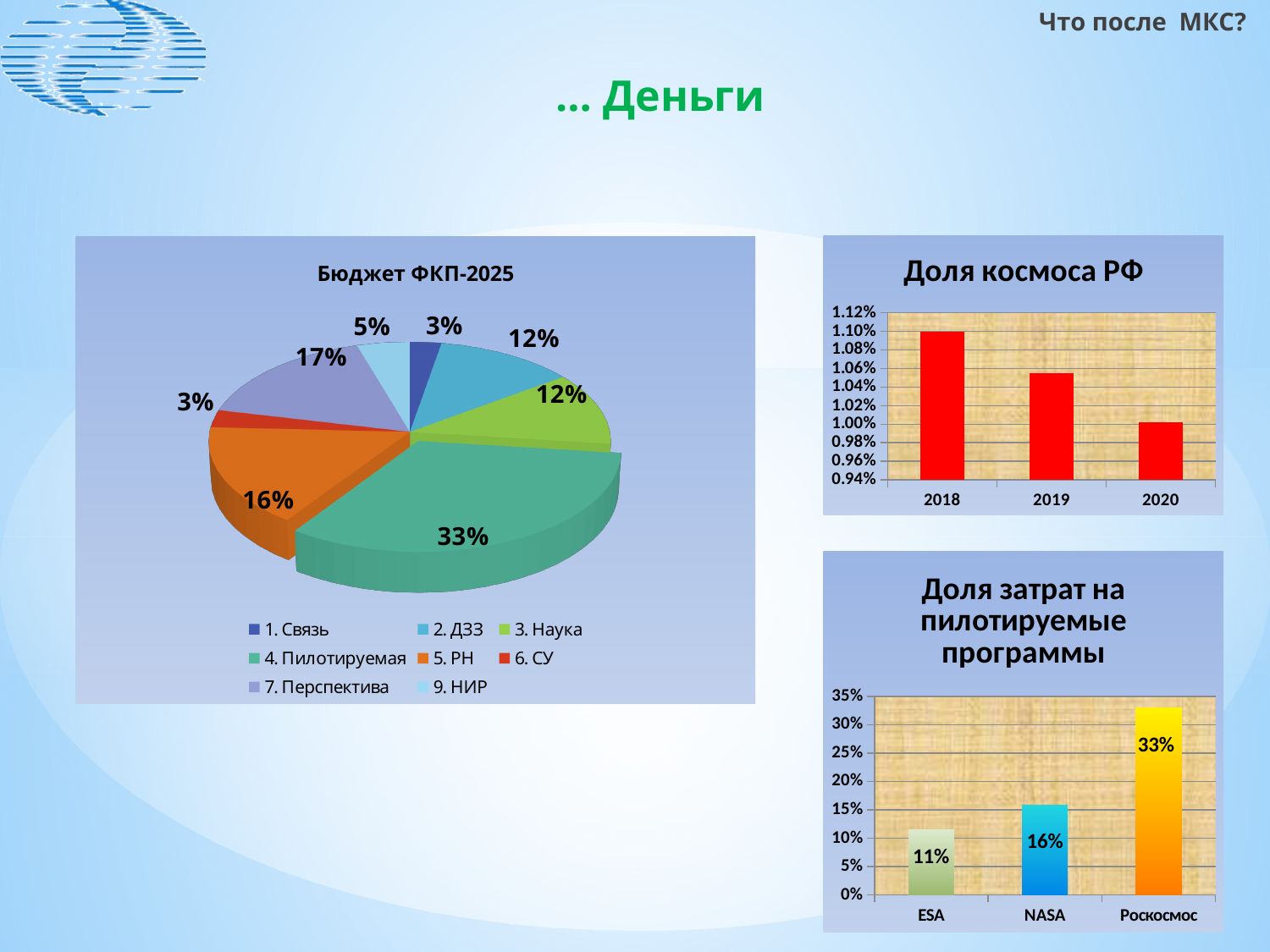
In the pie chart 'Бюджет ФКП-2025', which category has the largest share? 4. Пилотируемая In the chart 'Доля космоса РФ', do the values rise or fall from 2018 to 2020? fall In the pie chart 'Бюджет ФКП-2025', what share does '7. Перспектива' have? 17% In the chart 'Доля затрат на пилотируемые программы', what is the difference between Роскосмос and ESA? 22% In the pie chart 'Бюджет ФКП-2025', what is the difference between the shares of '5. РН' and '9. НИР'? 11% In the chart 'Доля затрат на пилотируемые программы', which category has the lowest value? ESA What kind of chart is 'Доля затрат на пилотируемые программы'? bar chart In the chart 'Доля космоса РФ', which year has the highest value? 2018 In the pie chart 'Бюджет ФКП-2025', how many slices are there? 8 In the pie chart 'Бюджет ФКП-2025', what share does '4. Пилотируемая' have? 33% In the chart 'Доля затрат на пилотируемые программы', what is the value for NASA? 16% In the chart 'Доля космоса РФ', is the value for 2019 greater or less than 1.02%? greater